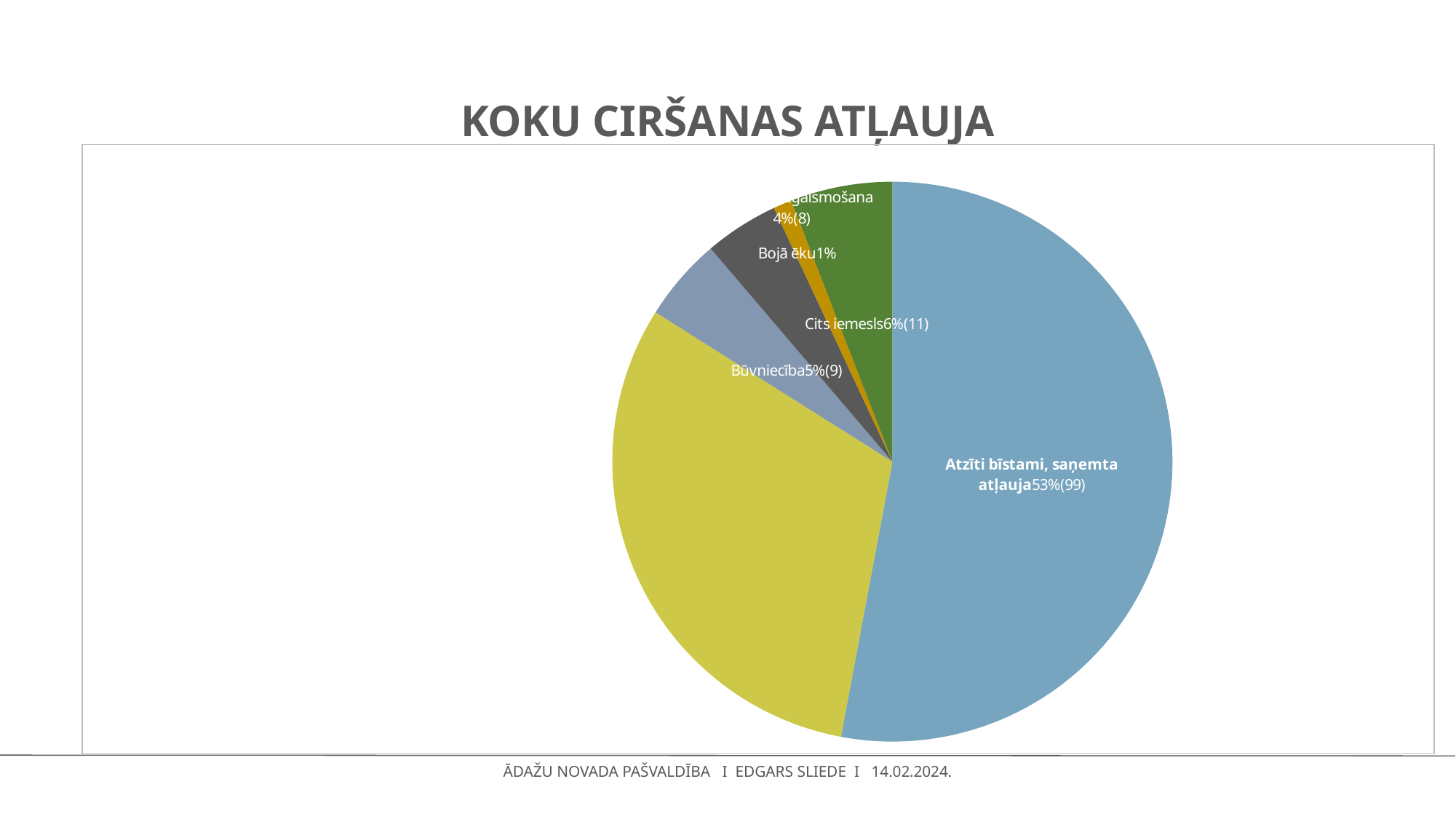
What percentage is shown for "Būvniecība"? 5% How many permits are shown in parentheses for "Atzīti bīstami, saņemta atļauja"? 99 What is the difference in count between "Atzīti bīstami, saņemta atļauja" (99) and "Cits iemesls" (11)? 88 How many slices does the pie chart have? 6 Which labelled slice has the smallest share of the pie? Bojā ēku Which labelled slice has the largest share of the pie? Atzīti bīstami, saņemta atļauja Which has a larger share, "Cits iemesls" or "Būvniecība"? Cits iemesls What type of chart is shown on the slide? pie chart What percentage is shown for "Bojā ēku"? 1% What count is shown in parentheses for "Cits iemesls"? 11 What is the title of the chart? KOKU CIRŠANAS ATĻAUJA What percentage share does the slice "Atzīti bīstami, saņemta atļauja" have? 53%